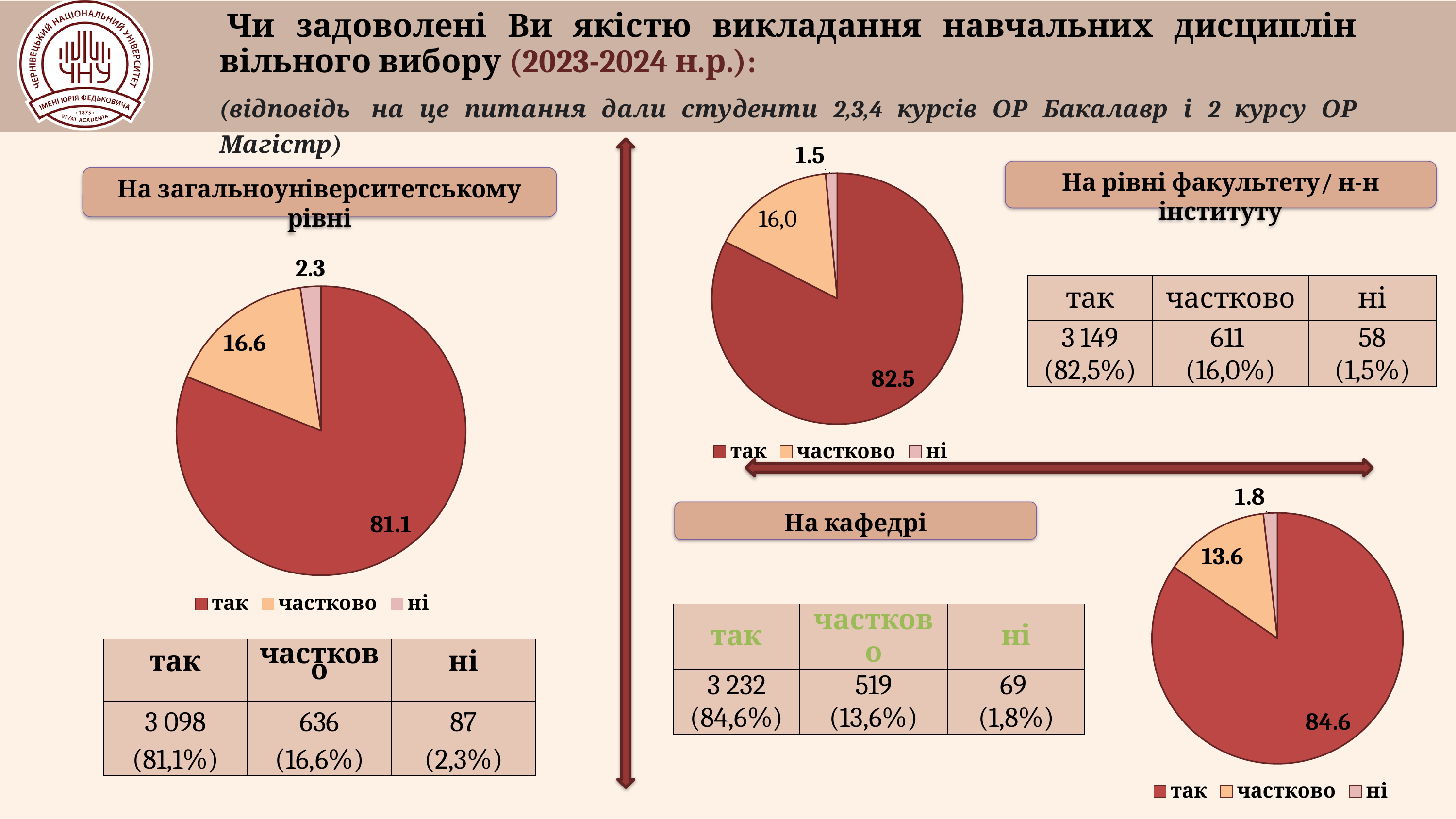
How many slices does the pie chart for 'На загальноуніверситетському рівні' have? 3 What type of chart is used for 'На кафедрі'? pie chart In the pie chart for 'На рівні факультету/ н-н інституту', which category has the smallest slice? ні In the pie chart for 'На кафедрі', what is the difference between the values for 'так' and 'частково'? 71.0 In the pie chart for 'На кафедрі', what value is shown for 'ні'? 1.8 In the pie chart for 'На загальноуніверситетському рівні', what value is shown for 'так'? 81.1 In the pie chart for 'На рівні факультету/ н-н інституту', what value is shown for 'частково'? 16,0 In the pie chart for 'На кафедрі', which category has the largest slice? так Which is larger: the 'частково' value in the 'На загальноуніверситетському рівні' pie chart or the 'частково' value in the 'На кафедрі' pie chart? На загальноуніверситетському рівні In the pie chart for 'На загальноуніверситетському рівні', what value is shown for 'ні'? 2.3 In the pie chart for 'На рівні факультету/ н-н інституту', what value is shown for 'так'? 82.5 In the pie chart for 'На загальноуніверситетському рівні', what value is shown for 'частково'? 16.6